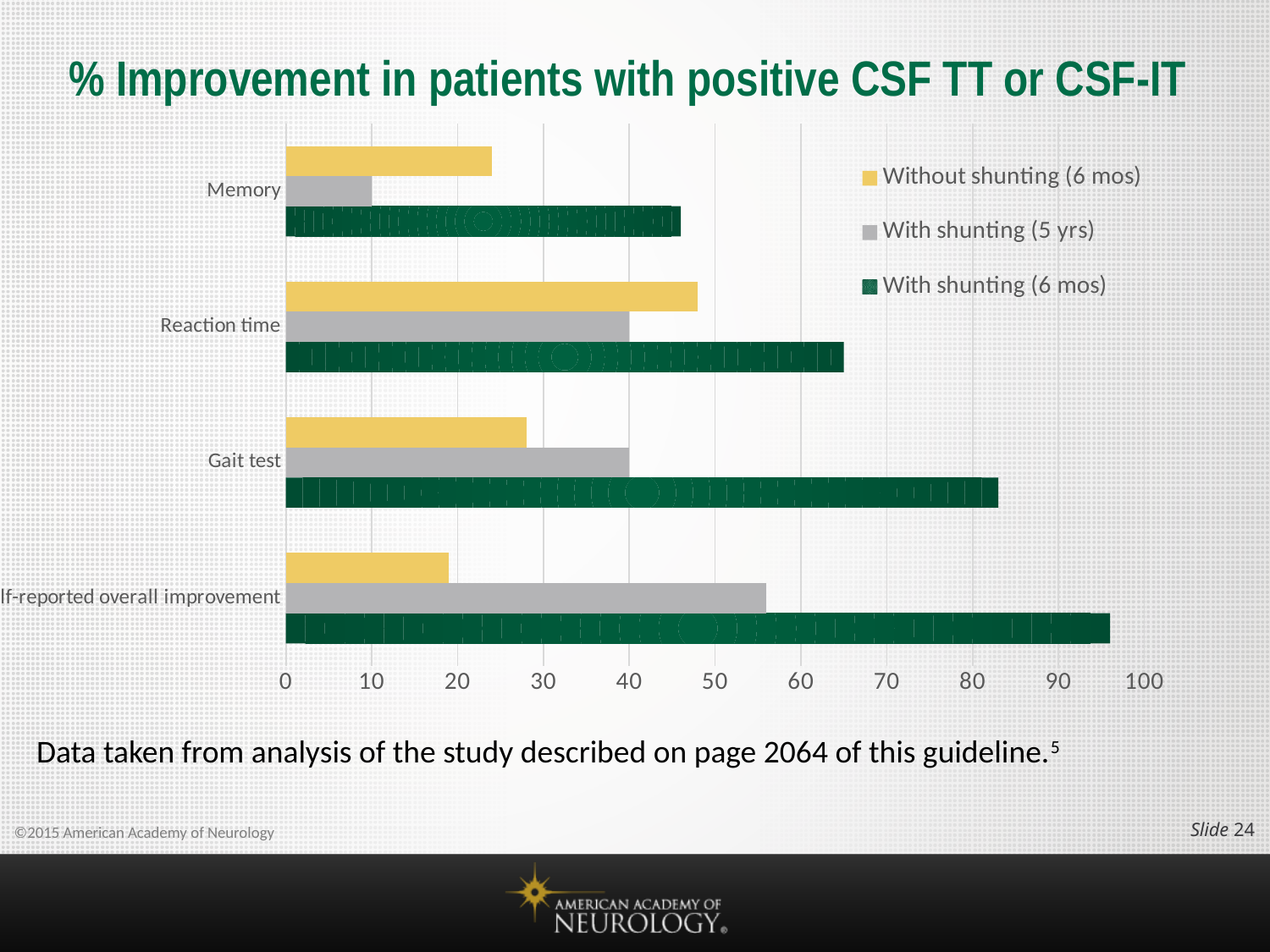
For Gait test, which is larger: Without shunting (6 mos) or With shunting (5 yrs)? With shunting (5 yrs) Which category has the highest value for With shunting (6 mos)? Self-reported overall improvement Is the With shunting (6 mos) value for Self-reported overall improvement greater or less than 90? greater Is the With shunting (6 mos) value for Memory greater or less than 40? greater How many series does the legend list? 3 What kind of chart is shown on the slide? Bar chart For Reaction time, which is larger: Without shunting (6 mos) or With shunting (5 yrs)? Without shunting (6 mos) How many categories are plotted on the y axis? 4 Is the Without shunting (6 mos) value for Memory greater or less than 30? less Which category has the highest value for Without shunting (6 mos)? Reaction time Which category has the lowest value for With shunting (5 yrs)? Memory